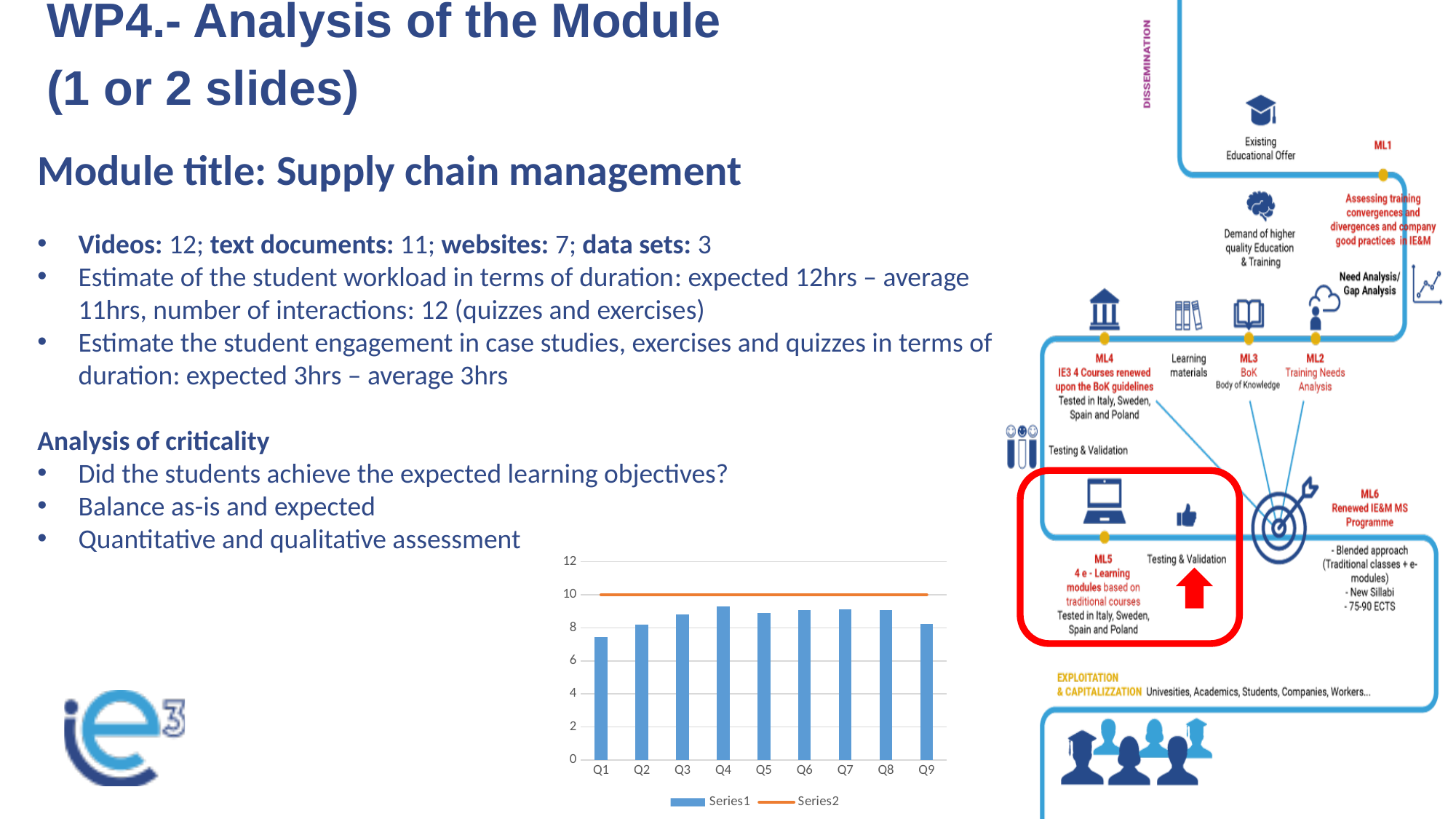
What colour is the Series2 line in the chart? orange At what value does the Series2 line sit across all categories? 10 What kind of chart is shown at the bottom of the slide? combination bar and line chart Which category has the lowest Series1 bar? Q1 Which category has the highest Series1 bar? Q4 What are the two entries in the chart legend? Series1 and Series2 How many series does the chart legend list? 2 How many categories are shown on the x axis of the chart? 9 Is the Series1 value for Q1 greater or less than 6? greater Is the Series1 value for Q4 greater or less than 8? greater Is the Series1 value for Q1 greater or less than 8? less Which is larger, the Series1 value for Q1 or for Q4? Q4